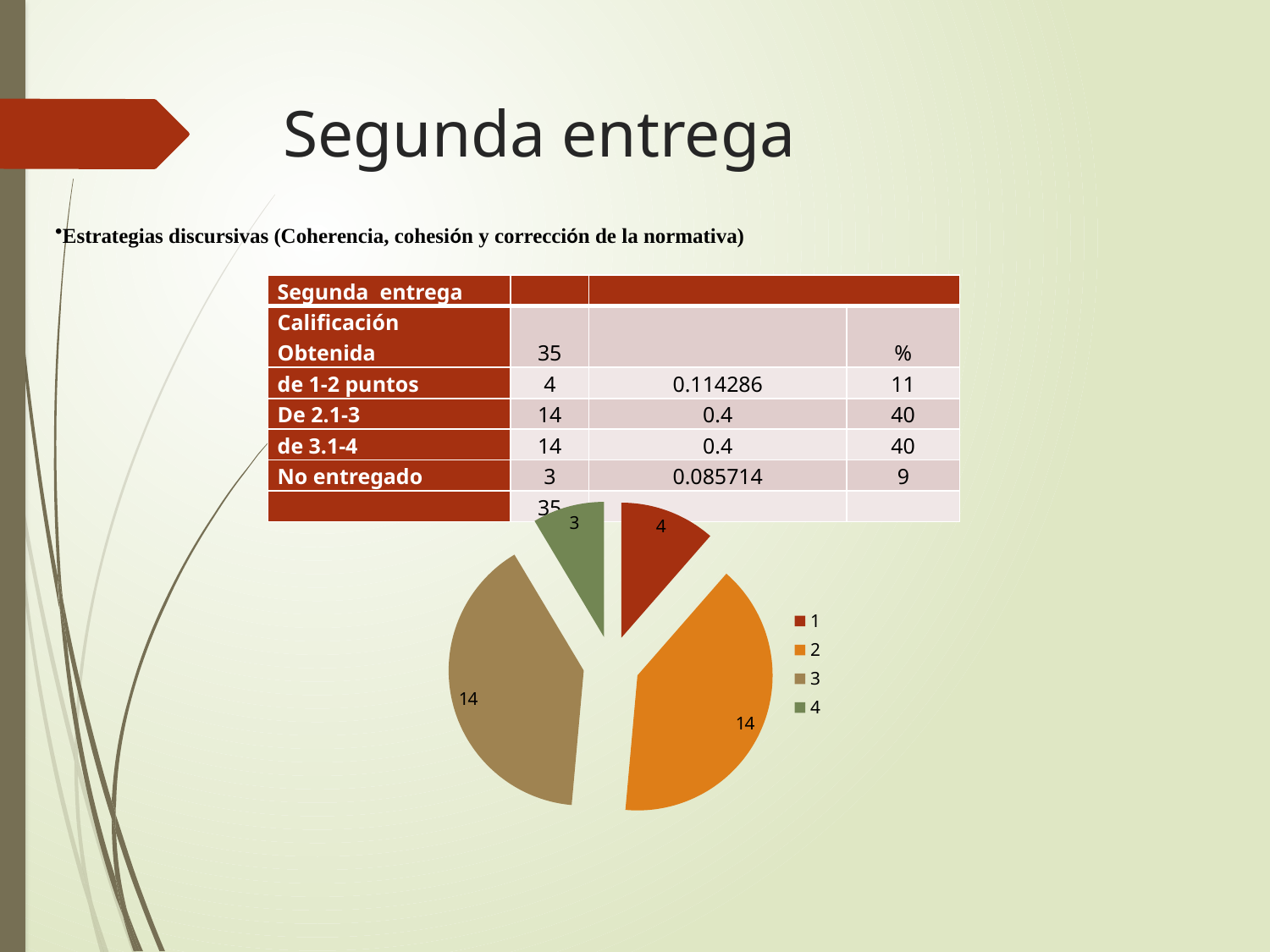
What is the value of slice 4 in the pie chart? 3 What entries are listed in the pie chart's legend? 1, 2, 3, 4 What type of chart is shown on the slide? pie chart What is the difference between the values of slice 3 and slice 4 in the pie chart? 11 What share of the pie does slice 2 represent? 40% Which is larger in the pie chart, slice 1 or slice 4? slice 1 How many slices does the pie chart have? 4 What is the value of slice 1 in the pie chart? 4 What is the total of all the slice values in the pie chart? 35 Which slice of the pie chart has the smallest value? 4 What is the value of slice 2 in the pie chart? 14 What is the difference between the values of slice 2 and slice 1 in the pie chart? 10